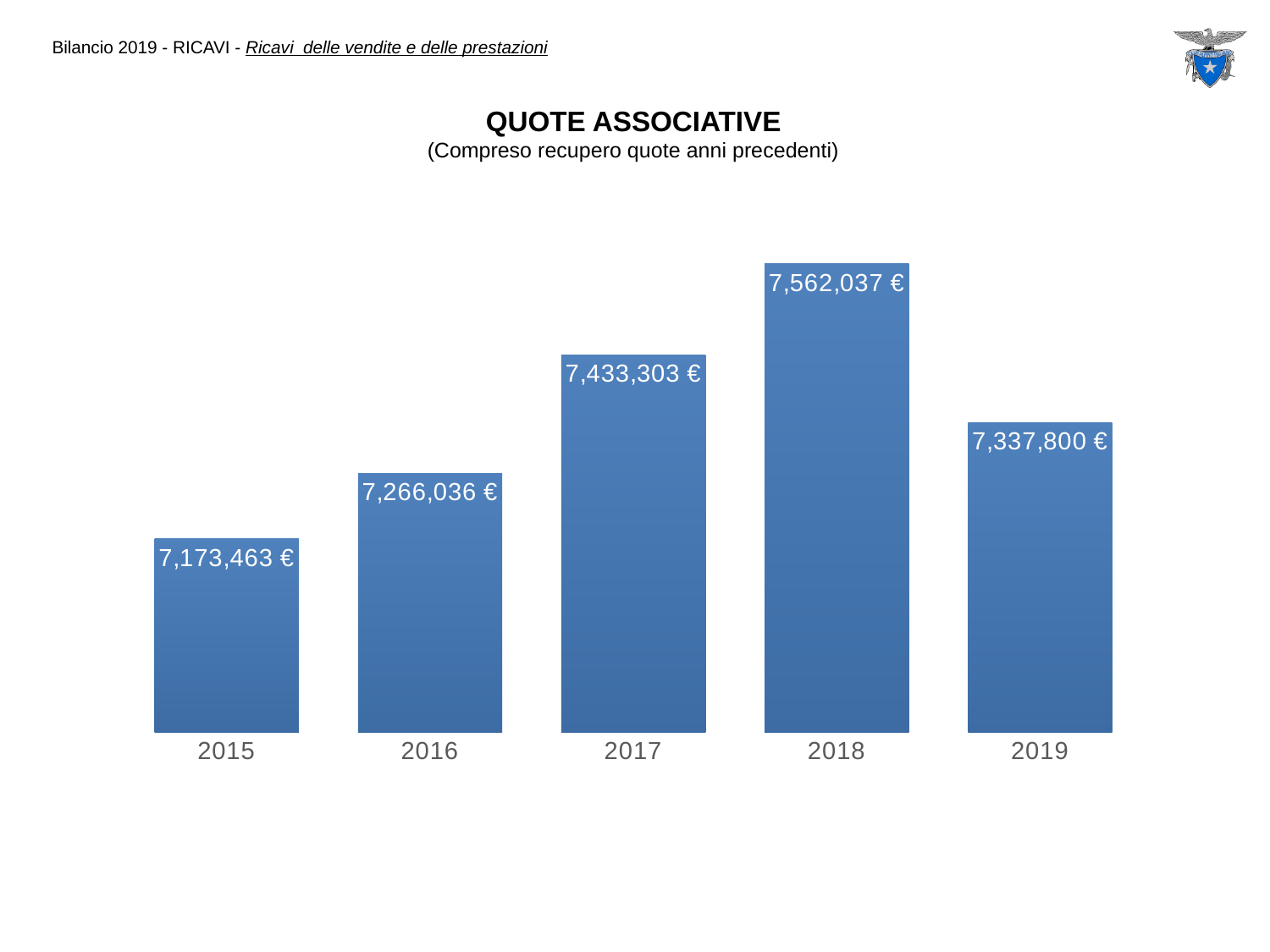
Which year has the lowest value? 2015 What is the difference between the values for 2018 and 2019? 224,237 € Which is larger, the value for 2017 or the value for 2019? 2017 What is the value for 2018? 7,562,037 € What is the value for 2015? 7,173,463 € What is the title of the chart? QUOTE ASSOCIATIVE How many years are shown in the chart? 5 How do the values change from 2015 to 2018? They rise each year What is the difference between the values for 2018 and 2017? 128,734 € What is the value for 2019? 7,337,800 € Which year has the highest value? 2018 What kind of chart is shown on the slide? Bar chart